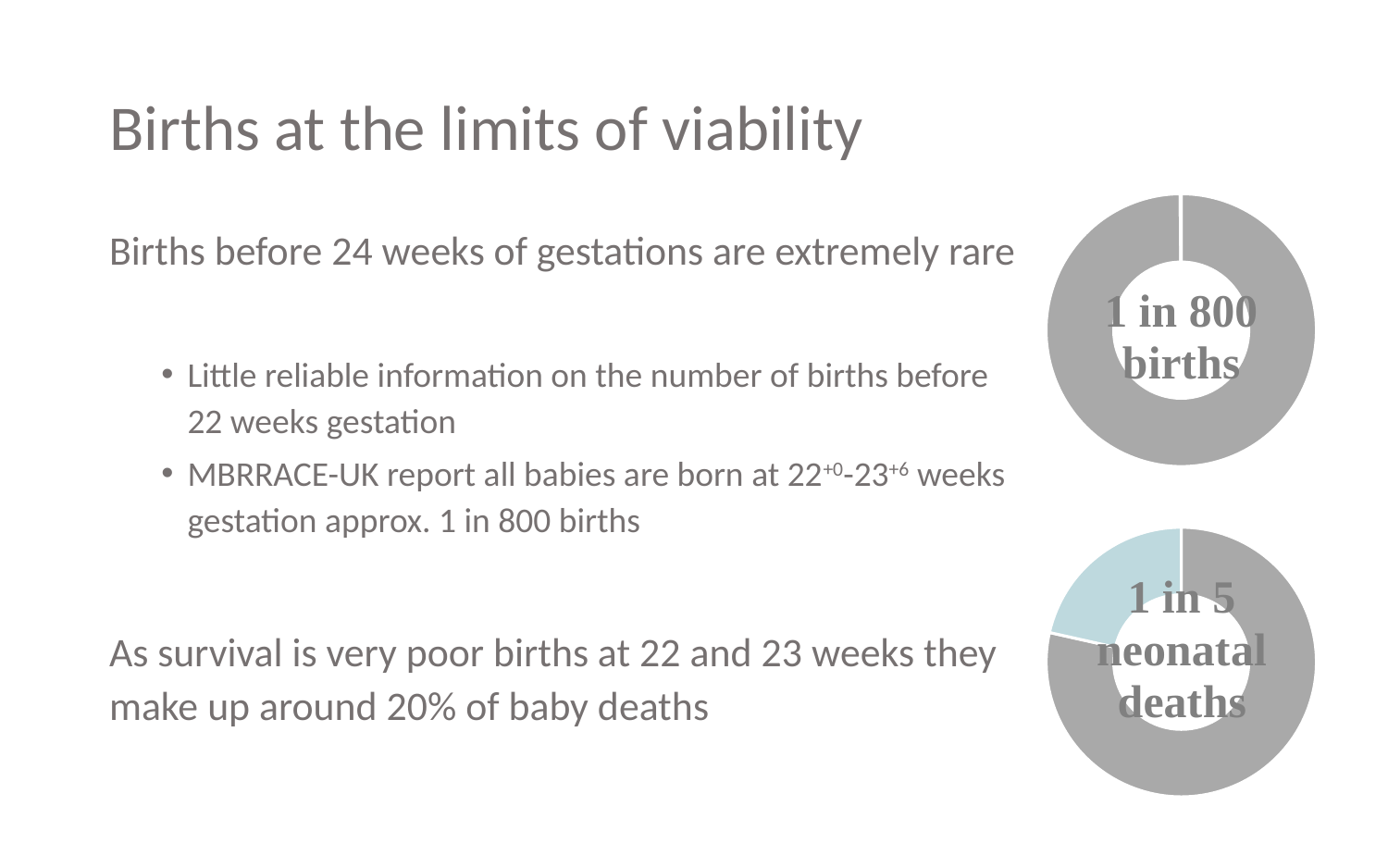
What text is printed in the centre of the top doughnut chart? 1 in 800 births In the top doughnut chart, which slice is larger, the grey slice or the thin white sliver? The grey slice In the top doughnut chart, what proportion of births does the small slice represent? 1 in 800 In the bottom doughnut chart, what share of neonatal deaths does the light blue slice represent? 1 in 5 What kind of chart is shown at the bottom right of the slide? Doughnut chart What text is printed in the centre of the bottom doughnut chart? 1 in 5 neonatal deaths Which doughnut chart has the larger highlighted slice, the top one (1 in 800 births) or the bottom one (1 in 5 neonatal deaths)? The bottom one (1 in 5 neonatal deaths) In the bottom doughnut chart, which slice is larger, the grey slice or the light blue slice? The grey slice How many slices does the bottom doughnut chart have? 2 How many doughnut charts are on the slide? 2 Is the light blue slice in the bottom doughnut chart greater or less than 50% of the ring? less What kind of chart is shown at the top right of the slide? Doughnut chart